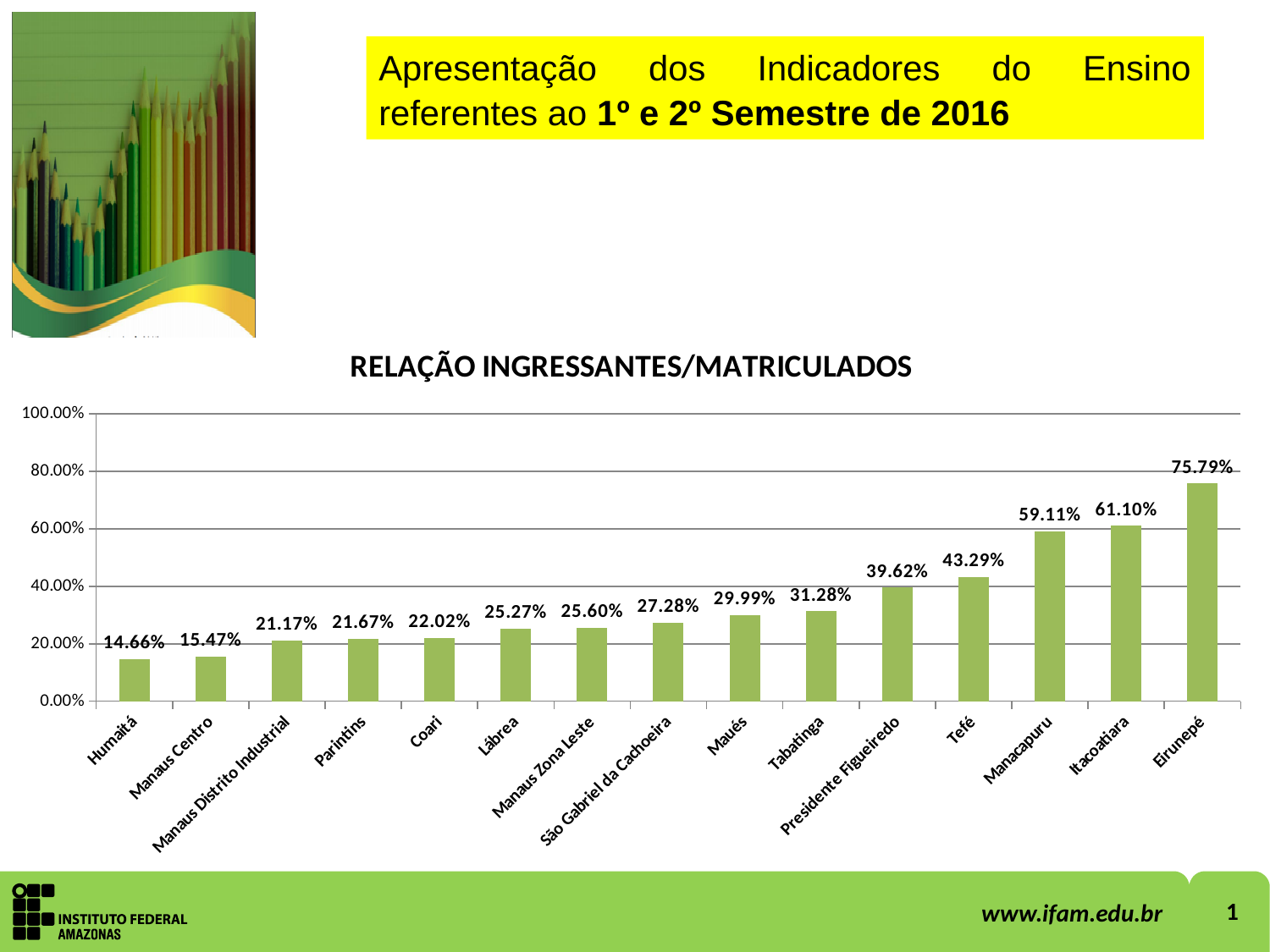
Which is larger, the value for Manacapuru or the value for Itacoatiara? Itacoatiara What is the value for Tefé in the chart? 43.29% What kind of chart is shown on the slide? Bar chart What is the value for São Gabriel da Cachoeira? 27.28% Which campus has the lowest value in the chart? Humaitá What is the title of the chart? RELAÇÃO INGRESSANTES/MATRICULADOS Is the value for Presidente Figueiredo greater or less than 40.00%? less Which campus has the highest value in the chart? Eirunepé What is the difference between the values for Tefé and Presidente Figueiredo? 3.67% What is the value for Manaus Zona Leste? 25.60% How many campuses are shown in the chart? 15 What is the difference between the values for Eirunepé and Humaitá? 61.13%